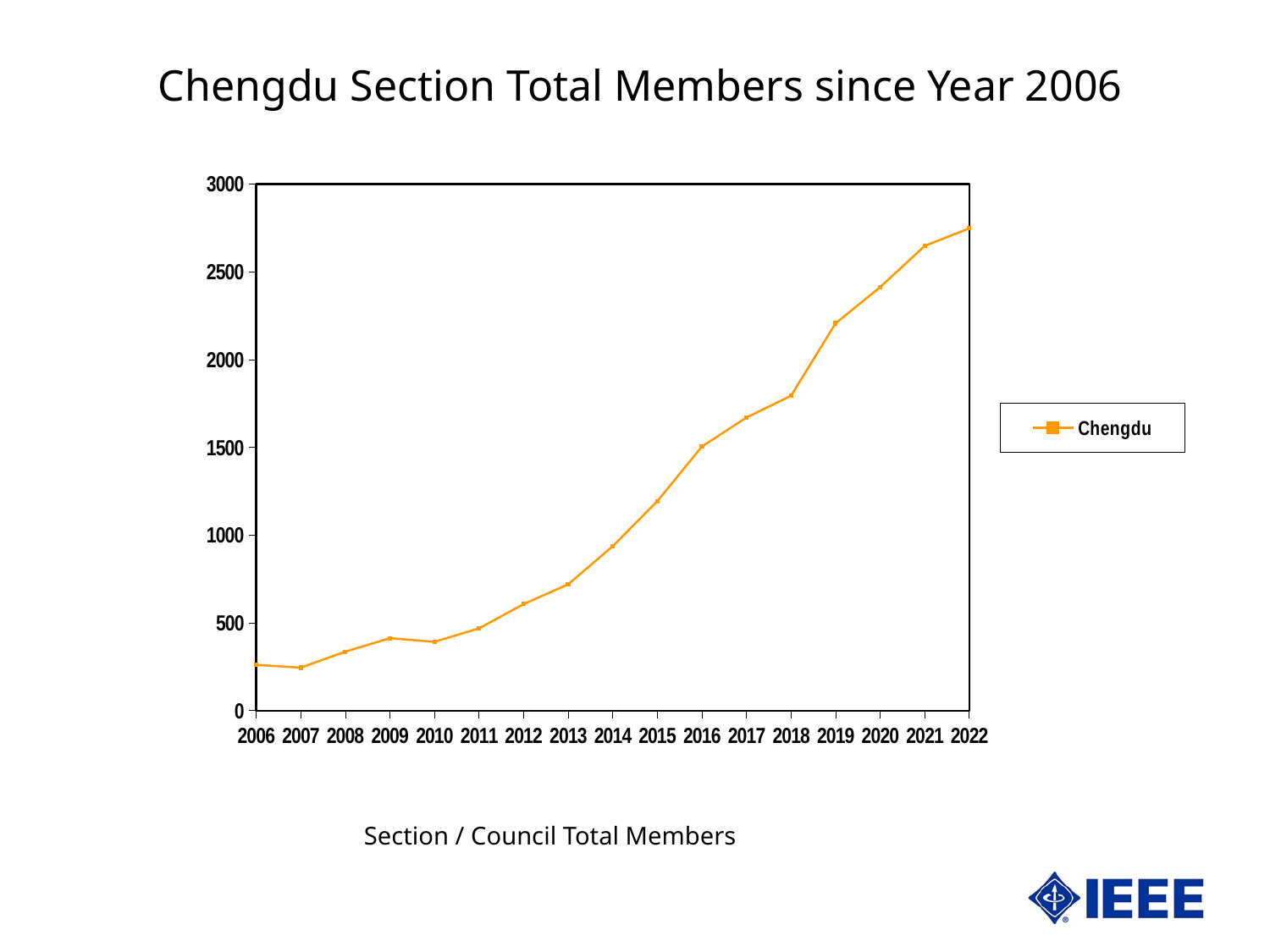
How many years are plotted along the x axis? 17 Which year has the larger value, 2013 or 2019? 2019 Which year has the highest number of members? 2022 Do the values generally rise or fall from 2006 to 2022? rise Is the value for 2022 greater or less than 2500? greater Is the value for 2006 greater or less than 500? less Is the value for 2019 greater or less than 2000? greater What is the title of the chart? Chengdu Section Total Members since Year 2006 What kind of chart is shown on the slide? line chart What is the name of the series shown in the legend? Chengdu How many series does the legend list? 1